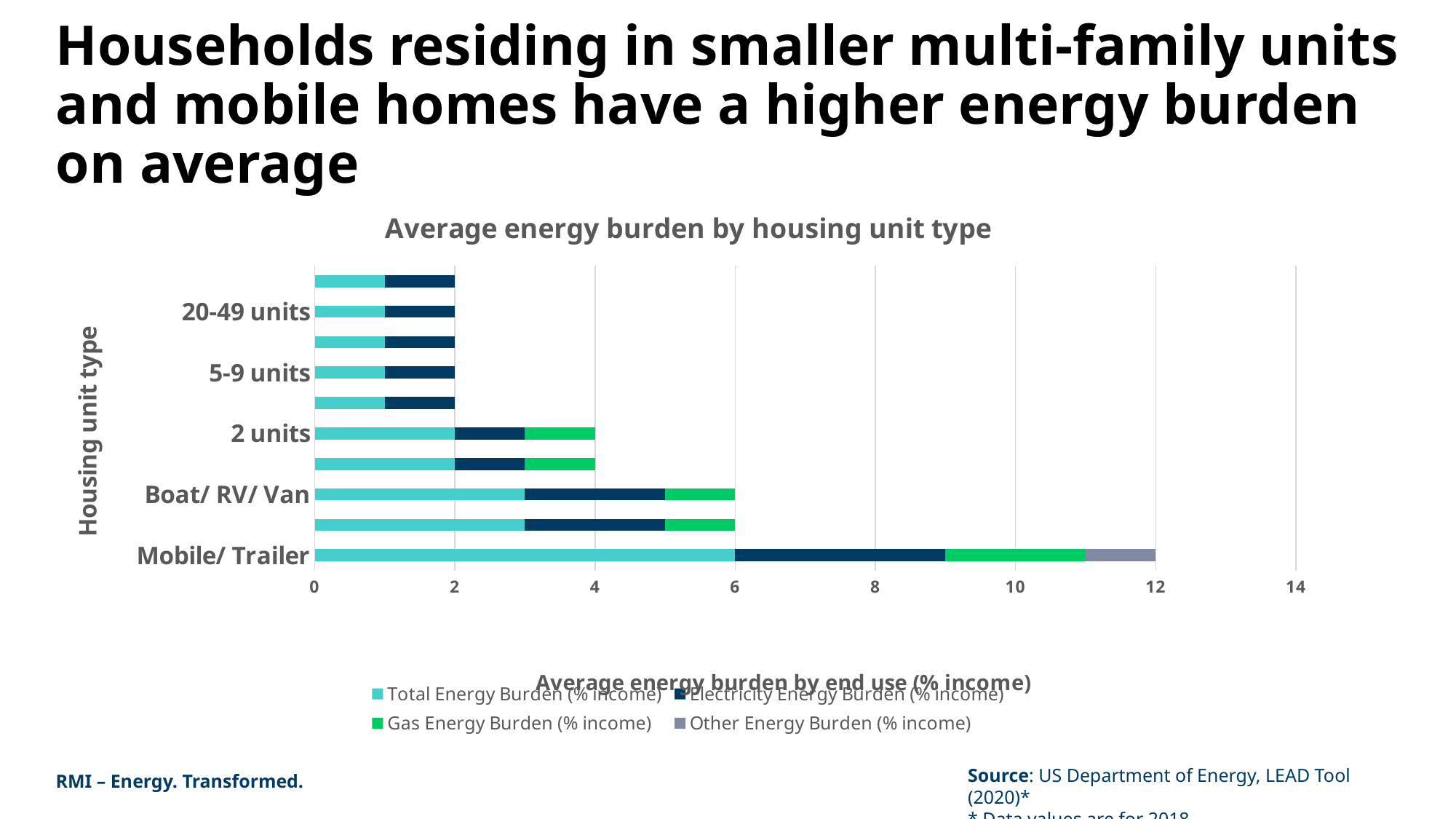
Which housing unit type has the longest bar? Mobile/ Trailer At what value on the x axis does the Mobile/ Trailer bar end? 12 Is the end of the Mobile/ Trailer bar greater or less than 10? greater What is the title of the chart? Average energy burden by housing unit type What is the difference between where the Mobile/ Trailer bar ends and where the Boat/ RV/ Van bar ends? 6 At what value on the x axis does the Boat/ RV/ Van bar end? 6 How many series does the legend list? 4 What kind of chart is shown on the slide? Stacked bar chart What is the Total Energy Burden (% income) value for Mobile/ Trailer? 6 What is the x-axis title of the chart? Average energy burden by end use (% income) Which bar is longer, Boat/ RV/ Van or 2 units? Boat/ RV/ Van